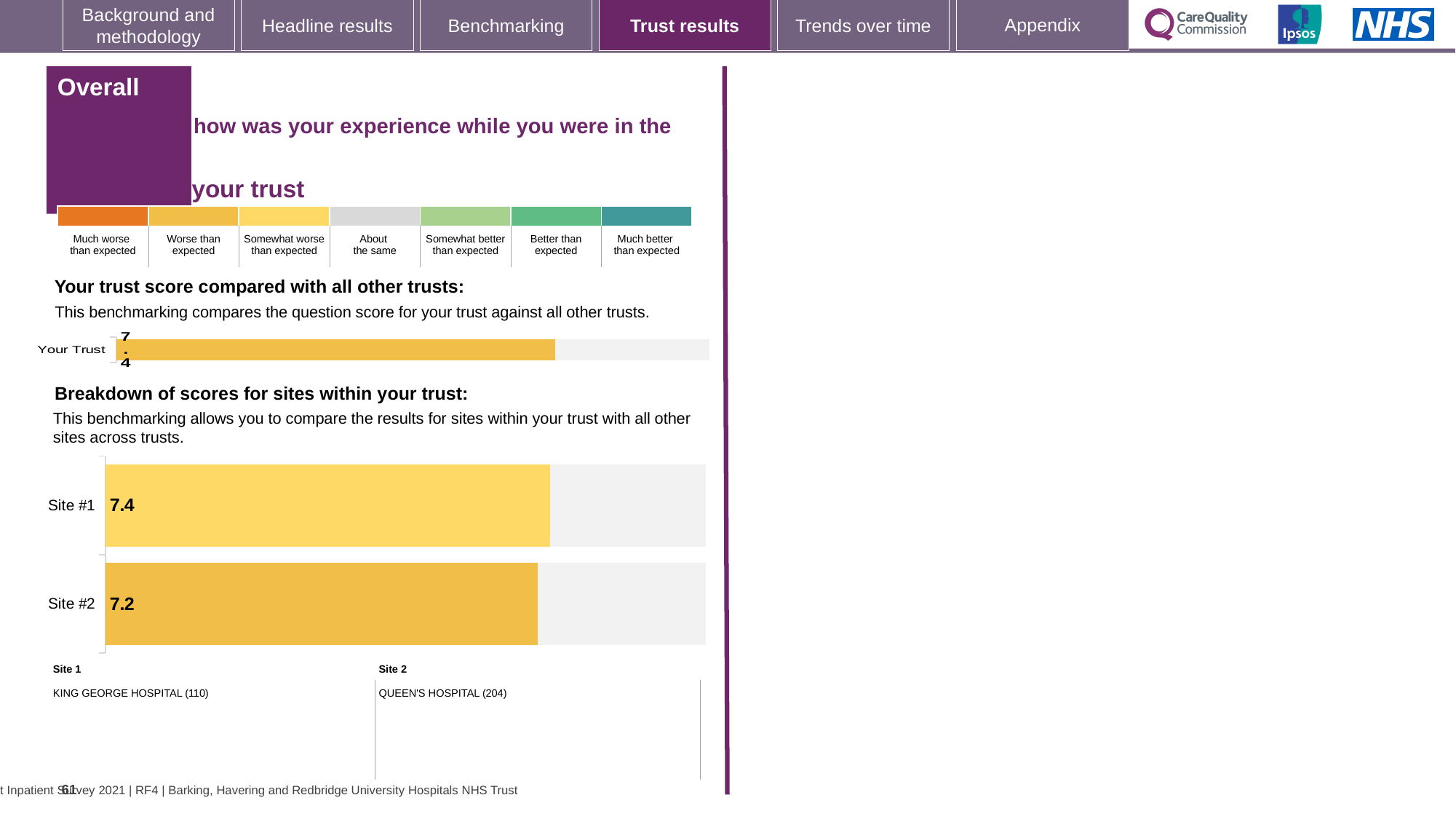
How many sites are shown in the 'Breakdown of scores for sites within your trust' chart? 2 According to the key below the 'Breakdown of scores for sites within your trust' chart, which hospital is Site 2? QUEEN'S HOSPITAL In the 'Breakdown of scores for sites within your trust' chart, which site has the lowest score? Site #2 In the 'Breakdown of scores for sites within your trust' chart, what is the difference between the scores of Site #1 and Site #2? 0.2 In the 'Breakdown of scores for sites within your trust' chart, which has the larger score, Site #1 or Site #2? Site #1 How many bars are shown in the 'Your trust score compared with all other trusts' chart? 1 In the 'Breakdown of scores for sites within your trust' chart, what is the score for Site #2? 7.2 According to the key below the 'Breakdown of scores for sites within your trust' chart, which hospital is Site 1? KING GEORGE HOSPITAL In the 'Breakdown of scores for sites within your trust' chart, which site has the highest score? Site #1 In the 'Your trust score compared with all other trusts' chart, what is the score for Your Trust? 7.4 What type of chart is used in the 'Breakdown of scores for sites within your trust' section? Bar chart In the 'Breakdown of scores for sites within your trust' chart, what is the score for Site #1? 7.4